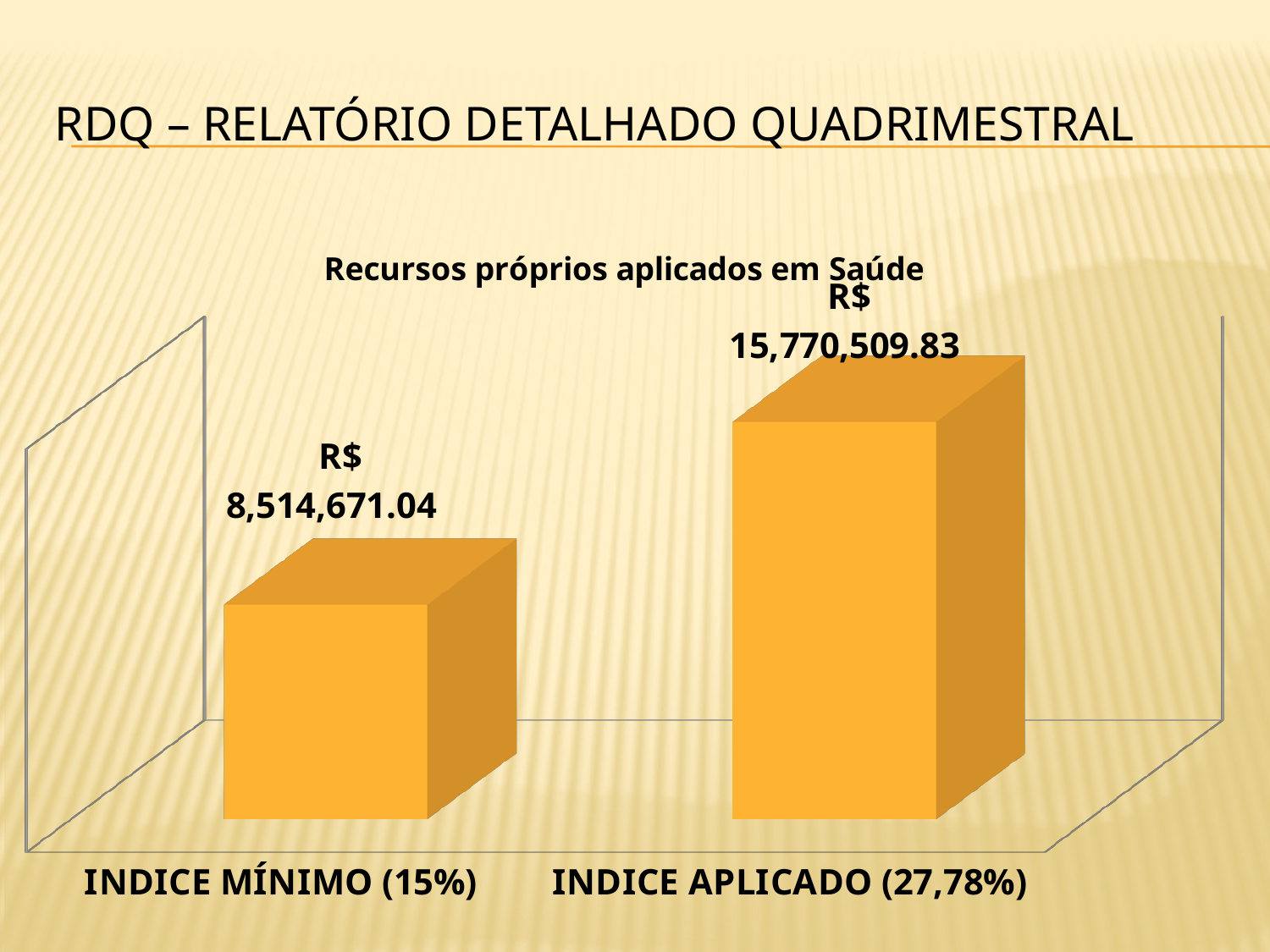
What kind of chart is shown on the slide? Bar chart What colour are the bars in the chart? Orange Which category has the highest value? INDICE APLICADO (27,78%) Do the values rise or fall from left to right across the categories? Rise What is the value for INDICE MÍNIMO (15%)? R$ 8,514,671.04 What is the difference between the value for INDICE APLICADO (27,78%) and the value for INDICE MÍNIMO (15%)? R$ 7,255,838.79 How many categories are shown in the chart? 2 What is the title of the chart? Recursos próprios aplicados em Saúde What is the value for INDICE APLICADO (27,78%)? R$ 15,770,509.83 Which category has the lowest value? INDICE MÍNIMO (15%) Which is larger, the value for INDICE MÍNIMO (15%) or the value for INDICE APLICADO (27,78%)? INDICE APLICADO (27,78%)